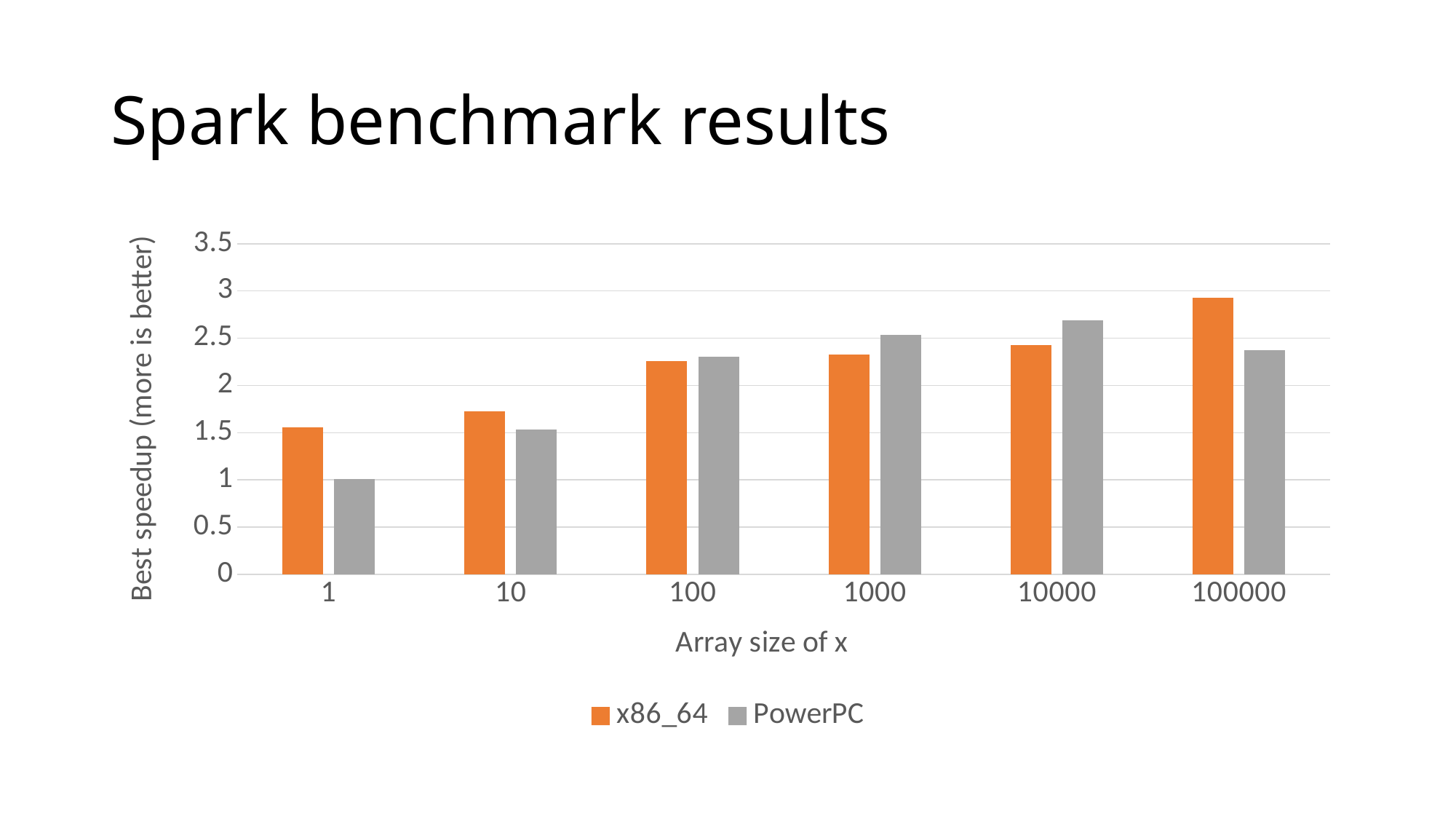
How many array sizes are shown on the x axis? 6 For which array size is the PowerPC speedup lowest? 1 Is the x86_64 speedup at array size 100000 greater or less than 2.5? greater For which array size is the PowerPC speedup highest? 10000 What is the label of the y axis? Best speedup (more is better) How many series does the legend list? 2 At array size 10000, which series has the larger speedup, x86_64 or PowerPC? PowerPC At array size 1, which series has the larger speedup, x86_64 or PowerPC? x86_64 Do the x86_64 speedup values rise or fall as the array size increases? rise What kind of chart is shown on the slide? bar chart For which array size is the x86_64 speedup highest? 100000 Is the PowerPC speedup at array size 10 greater or less than 2? less